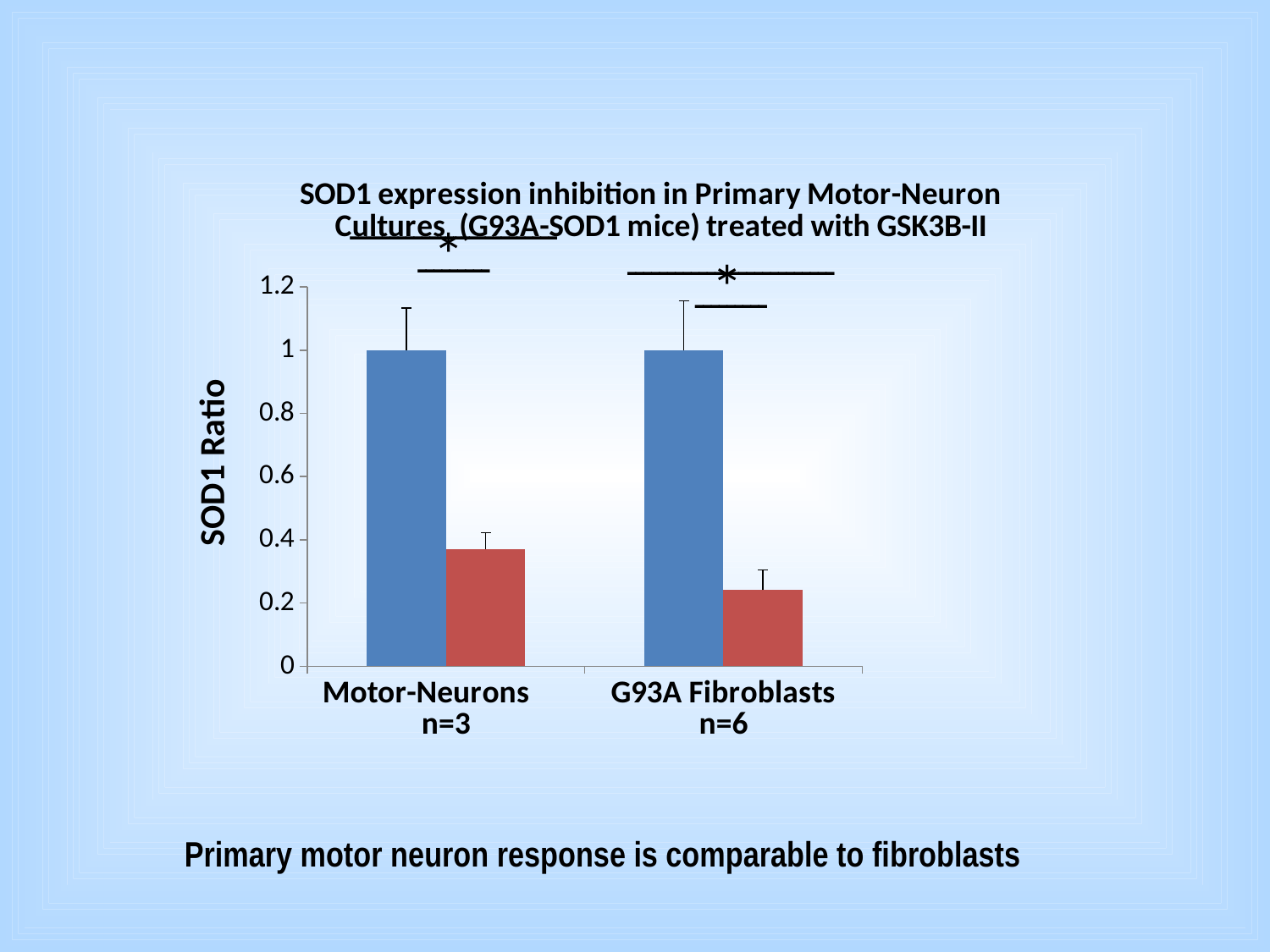
Is the value of the red bar for Motor-Neurons n=3 greater or less than 0.2? greater What kind of chart is shown on the slide? bar chart What is the SOD1 Ratio of the blue bar for Motor-Neurons n=3? 1 What is the SOD1 Ratio of the blue bar for G93A Fibroblasts n=6? 1 How many bars are plotted for each category? 2 Within the Motor-Neurons n=3 category, which bar is larger, the blue bar or the red bar? the blue bar How many categories are shown on the x axis of the chart? 2 Which category has the larger red bar, Motor-Neurons n=3 or G93A Fibroblasts n=6? Motor-Neurons n=3 What is the label of the y axis? SOD1 Ratio Is the value of the red bar for G93A Fibroblasts n=6 greater or less than 0.4? less Is the value of the red bar for Motor-Neurons n=3 greater or less than 0.6? less Which bar in the chart has the lowest SOD1 Ratio? the red bar for G93A Fibroblasts n=6